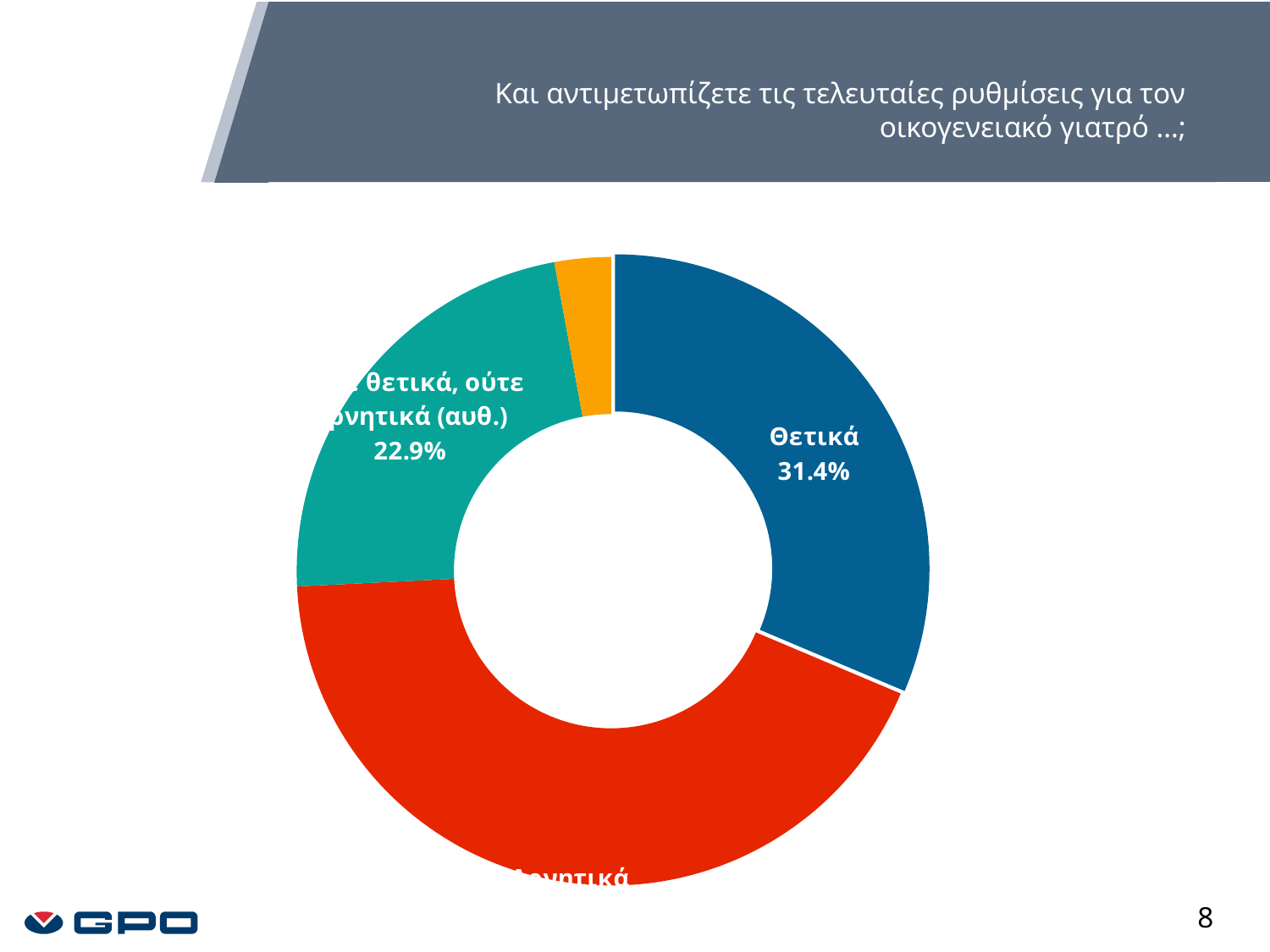
Which slice is larger, the red slice or the blue Θετικά slice? The red slice What is the difference in percentage points between the Θετικά slice (31.4%) and the 'Ούτε θετικά, ούτε αρνητικά (αυθ.)' slice (22.9%)? 8.5 percentage points Is the share of the red slice greater or less than 30%? greater What kind of chart is shown on the slide? Pie chart (donut) What colour is the Θετικά slice? Blue What percentage is shown for the 'Ούτε θετικά, ούτε αρνητικά (αυθ.)' slice? 22.9% What percentage is shown for the Θετικά slice? 31.4% What question is shown as the title of the slide? Και αντιμετωπίζετε τις τελευταίες ρυθμίσεις για τον οικογενειακό γιατρό ...; Which is larger, the Θετικά slice or the 'Ούτε θετικά, ούτε αρνητικά (αυθ.)' slice? Θετικά What colour is the smallest slice of the chart? Orange How many slices does the chart have? 4